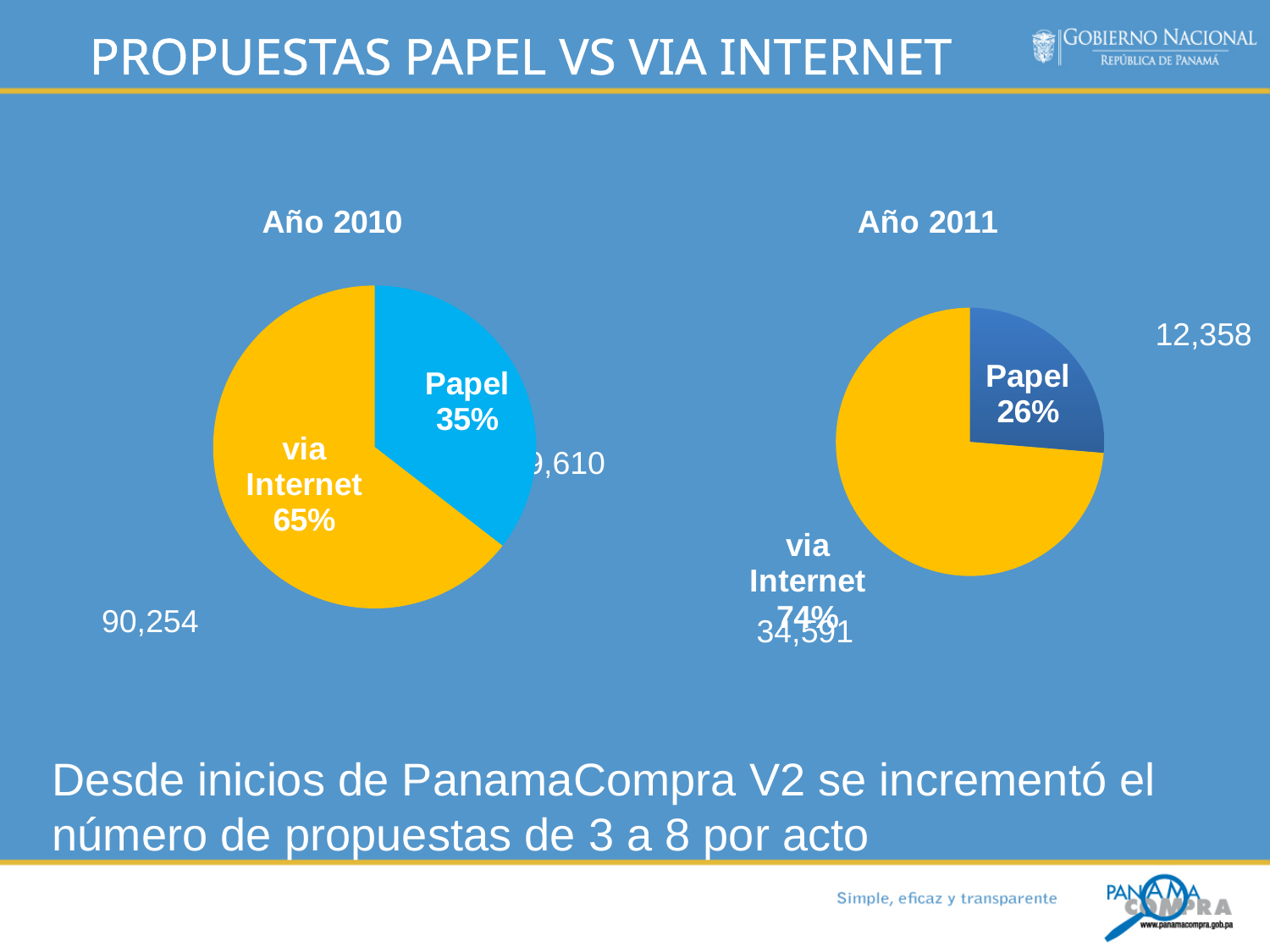
In the Año 2011 chart, what share of proposals was Papel? 26% What kind of chart is the Año 2011 chart? Pie chart In the Año 2011 chart, what value is shown for via Internet? 34,591 In the Año 2011 chart, what is the difference between the via Internet value and the Papel value? 22,233 In the Año 2010 chart, what share of proposals was Papel? 35% In the Año 2011 chart, what share of proposals was via Internet? 74% In the Año 2011 chart, which category has the smallest slice? Papel How many slices does the Año 2010 pie chart have? 2 In the Año 2011 chart, what value is shown for Papel? 12,358 In the Año 2010 chart, which slice is larger, Papel or via Internet? via Internet In the Año 2010 chart, what value is shown for via Internet? 90,254